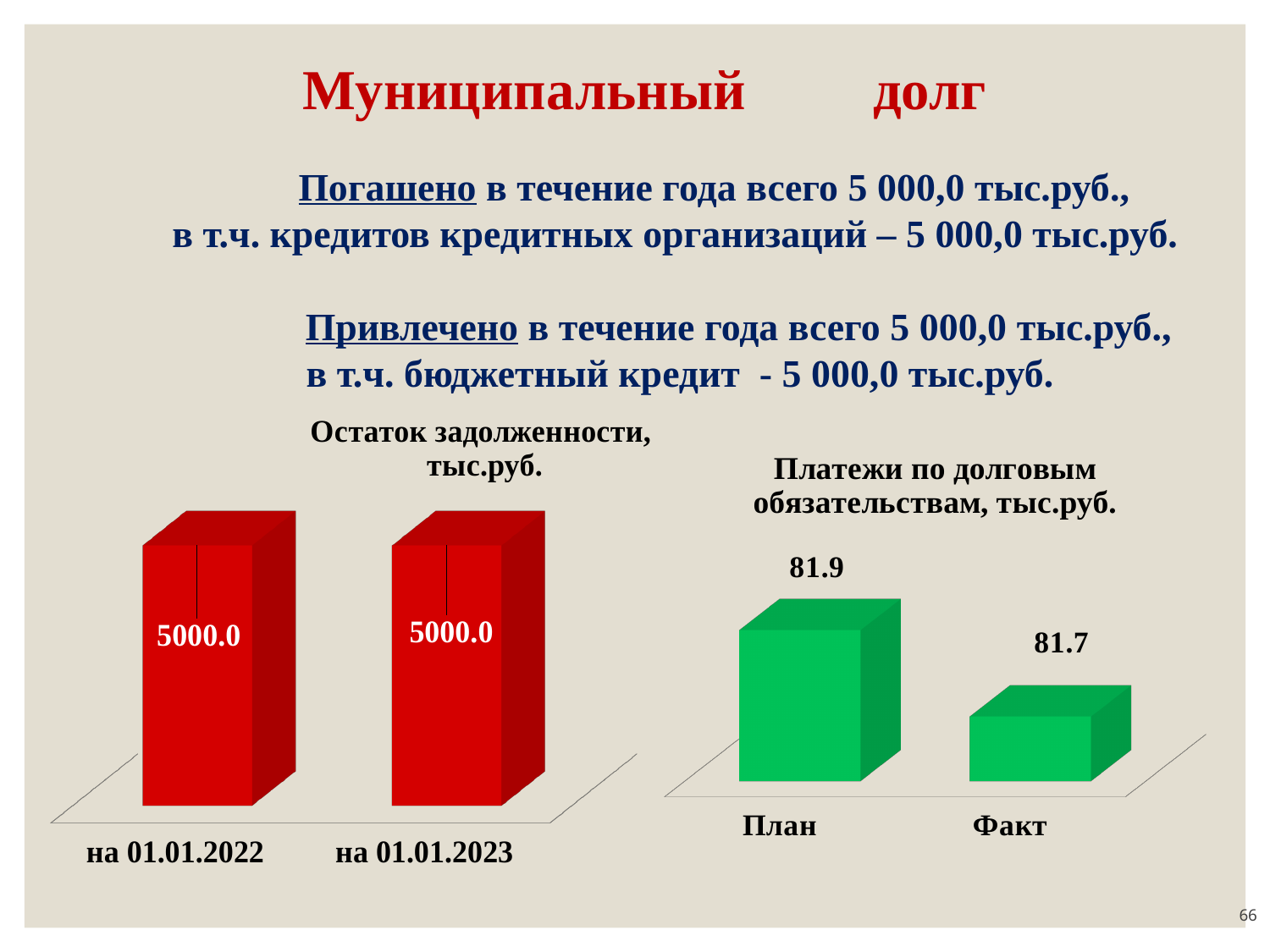
In the chart 'Платежи по долговым обязательствам, тыс.руб.', what is the value for 'План'? 81.9 In the chart 'Платежи по долговым обязательствам, тыс.руб.', how many categories are shown? 2 In the chart 'Остаток задолженности, тыс.руб.', how many bars are plotted? 2 In the chart 'Платежи по долговым обязательствам, тыс.руб.', what is the value for 'Факт'? 81.7 What kind of chart is 'Остаток задолженности, тыс.руб.'? bar chart In the chart 'Платежи по долговым обязательствам, тыс.руб.', what is the difference between 'План' and 'Факт'? 0.2 What colour are the bars in the chart 'Платежи по долговым обязательствам, тыс.руб.'? green In the chart 'Остаток задолженности, тыс.руб.', what is the value for 'на 01.01.2023'? 5000.0 In the chart 'Платежи по долговым обязательствам, тыс.руб.', which category has the higher value? План In the chart 'Остаток задолженности, тыс.руб.', does the value rise, fall or stay the same from 01.01.2022 to 01.01.2023? stays the same In the chart 'Остаток задолженности, тыс.руб.', what is the value for 'на 01.01.2022'? 5000.0 In the chart 'Остаток задолженности, тыс.руб.', what is the difference between the values for 'на 01.01.2023' and 'на 01.01.2022'? 0.0